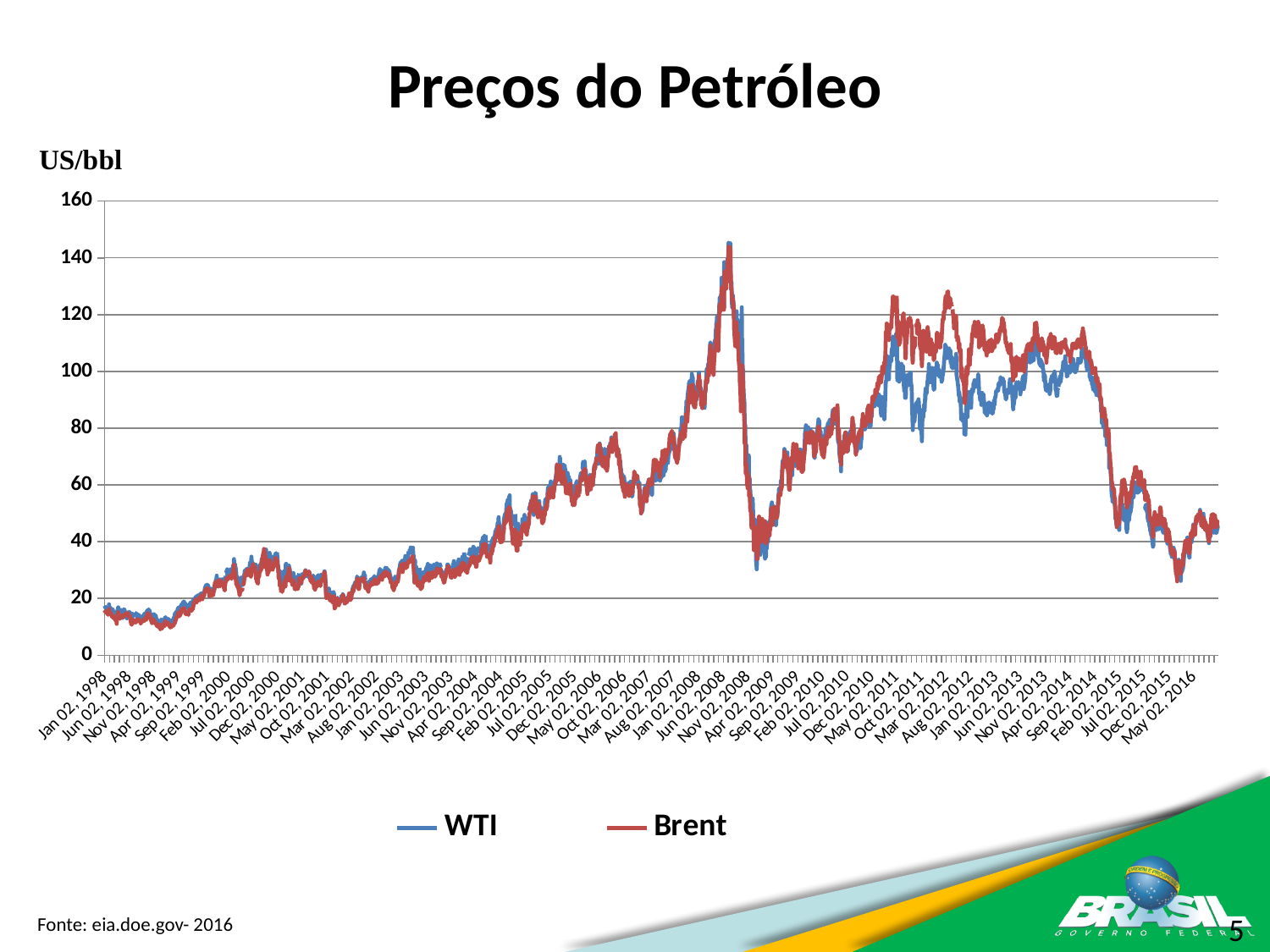
Is the value of the WTI series at Jan 02, 1998 greater or less than 20? less Is the peak value of the Brent series around Jul 02, 2008 greater or less than 140? greater Around Jan 02, 2013, which series has the higher value, WTI or Brent? Brent What is the title of the chart? Preços do Petróleo Is the value of the Brent series around Mar 02, 2012 greater or less than 100? greater What kind of chart is shown on the slide? line chart Which colour represents the Brent series in the chart? red What is the highest value shown on the vertical axis? 160 Do the prices rise or fall between Jan 02, 2002 and Jan 02, 2008? rise How many series does the legend list? 2 Do the prices rise or fall between Sep 02, 2014 and Jan 02, 2015? fall